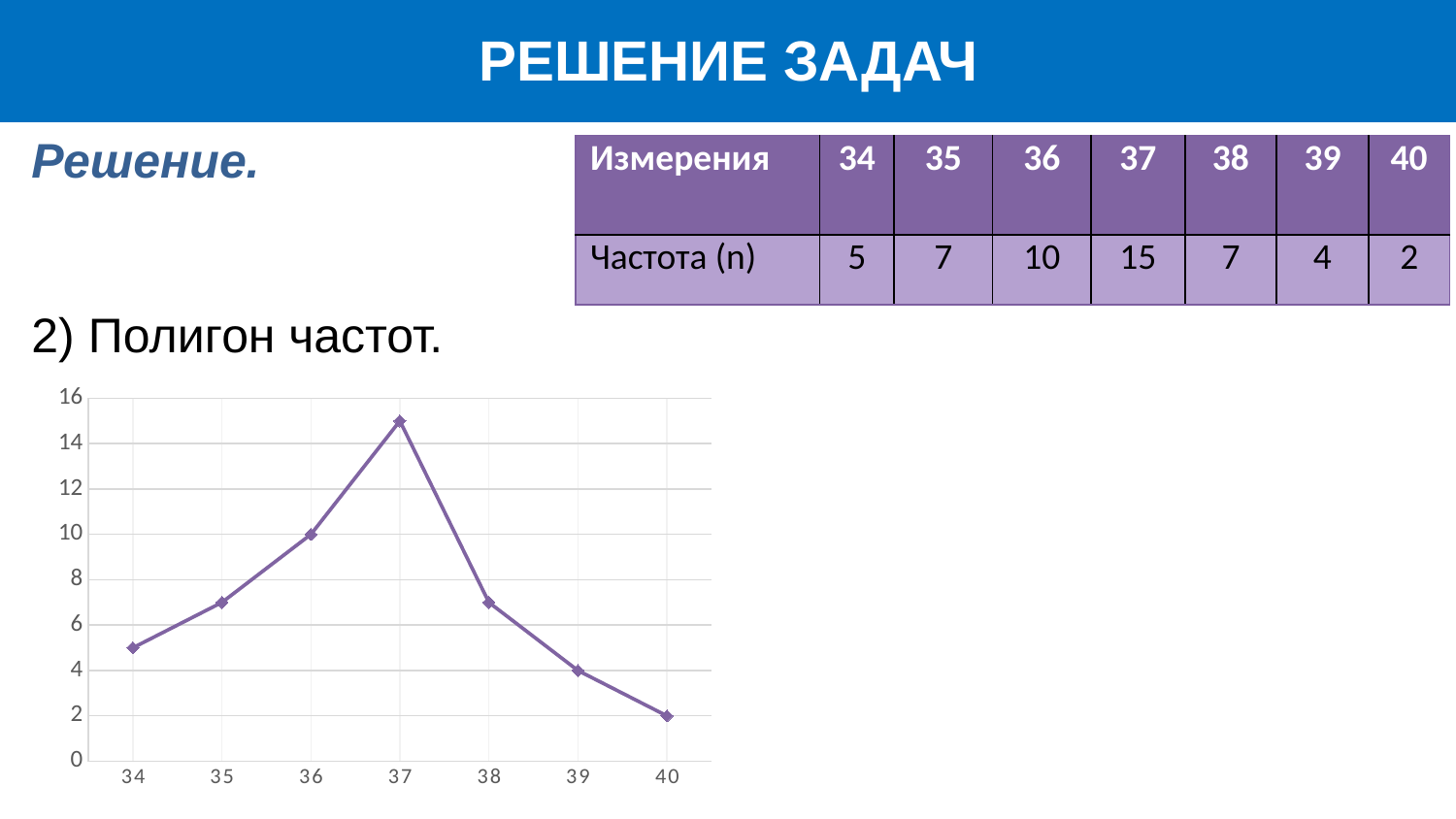
At which x value does the chart reach its highest point? 37 Do the values rise or fall along the x axis from 37 to 40? fall What is the value plotted at x = 37? 15 Is the value at x = 34 greater or less than 6? less What is the value plotted at x = 40? 2 Which is larger: the value at x = 36 or the value at x = 39? 36 At which x value does the chart reach its lowest point? 40 What type of chart is shown on the slide? line chart Is the value at x = 38 greater or less than 6? greater What is the difference between the value at x = 37 and the value at x = 36? 5 What is the value plotted at x = 36? 10 How many data points are plotted on the chart? 7